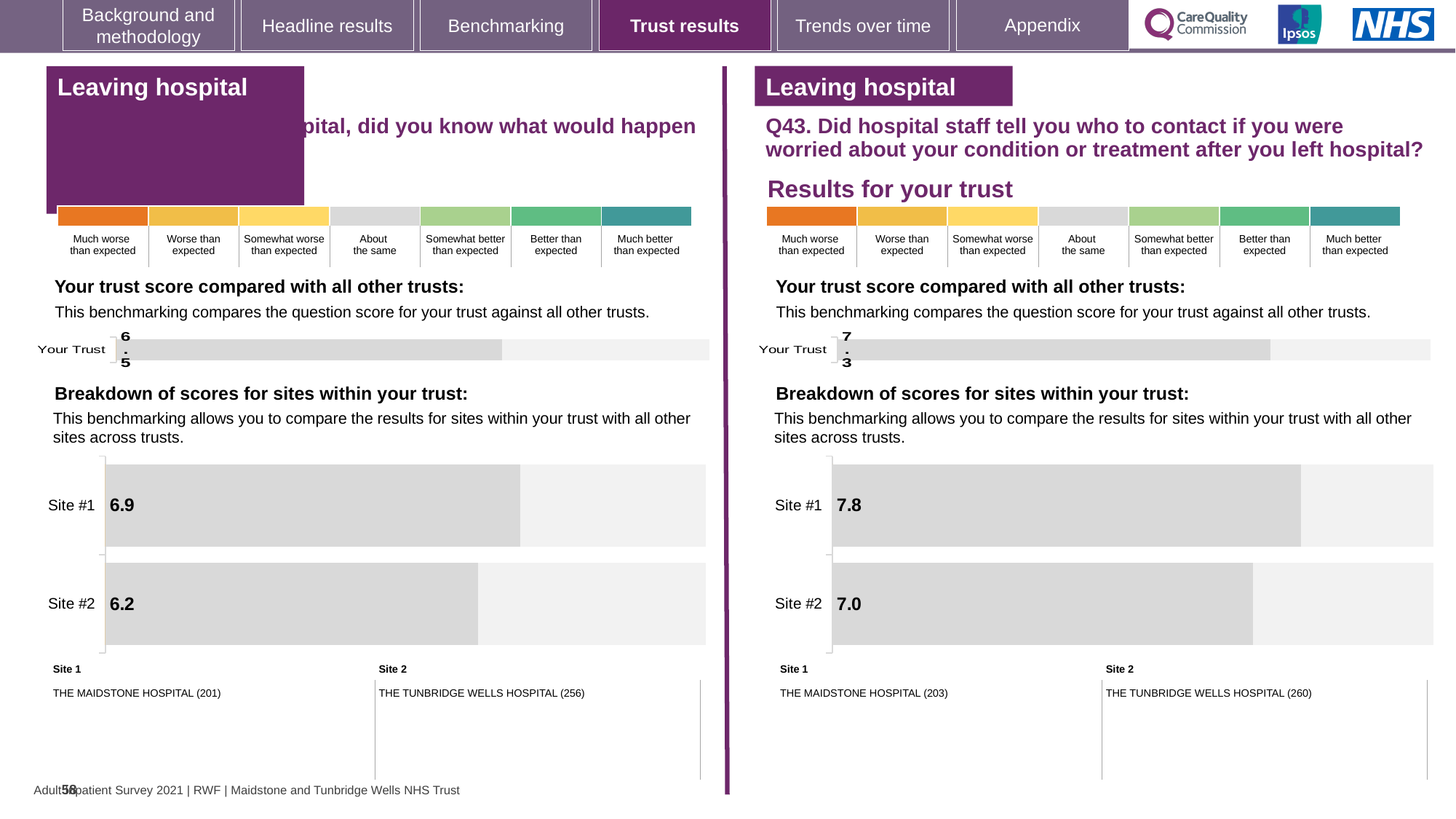
On the right-hand side of the slide (Q43), what is the score shown for Your Trust in the 'Your trust score compared with all other trusts' chart? 7.3 In the right-hand 'Breakdown of scores for sites within your trust' chart (Q43), what is the score for Site #1? 7.8 How many sites are shown in the right-hand 'Breakdown of scores for sites within your trust' chart (Q43)? 2 In the left-hand 'Breakdown of scores for sites within your trust' chart, what is the score for Site #1? 6.9 In the right-hand 'Breakdown of scores for sites within your trust' chart (Q43), what is the score for Site #2? 7.0 In the right-hand site breakdown chart (Q43), what is the difference between the Site #1 and Site #2 scores? 0.8 In the left-hand 'Breakdown of scores for sites within your trust' chart, what is the score for Site #2? 6.2 In the left-hand site breakdown chart, what is the difference between the Site #1 and Site #2 scores? 0.7 What type of chart is used for the site breakdown on the left-hand side of the slide? Bar chart In the right-hand site breakdown chart (Q43), which site has the higher score? Site #1 In the left-hand site breakdown chart, which site has the lower score? Site #2 On the left-hand side of the slide, what is the score shown for Your Trust in the 'Your trust score compared with all other trusts' chart? 6.5